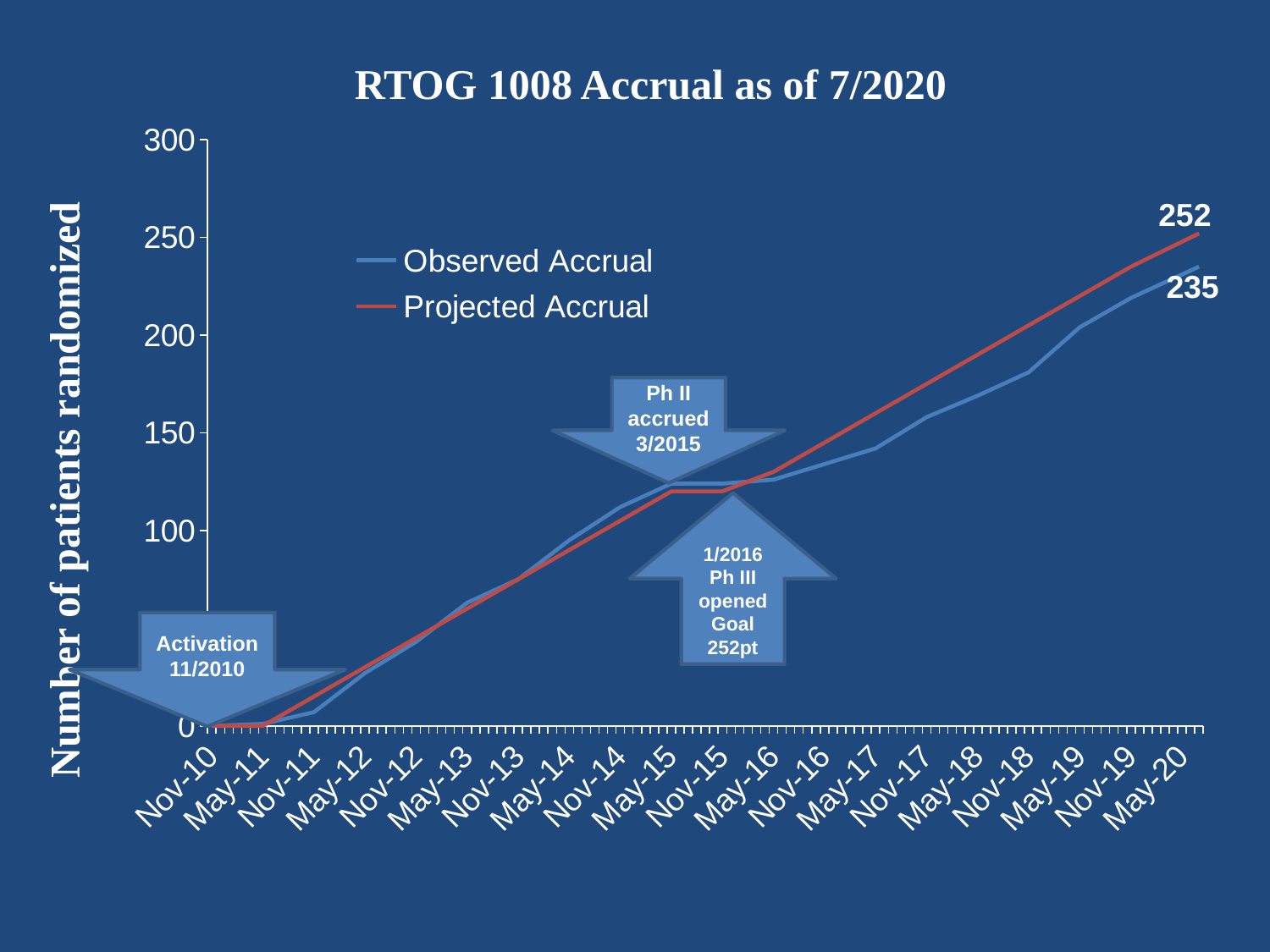
What is the difference between the final Projected Accrual value and the final Observed Accrual value? 17 Do the accrual lines rise or fall from Nov-10 to May-20? rise What kind of chart is shown on the slide? line chart Is the Observed Accrual value at Nov-13 greater or less than 100? less How many series does the legend list? 2 What is the label of the vertical axis? Number of patients randomized At the end of the chart, which line is higher: Observed Accrual or Projected Accrual? Projected Accrual Is the Projected Accrual value at May-19 greater or less than 200? greater What is the title of the chart? RTOG 1008 Accrual as of 7/2020 What is the final labelled value of the Observed Accrual line? 235 Is the Observed Accrual value at Nov-18 greater or less than 150? greater What is the final labelled value of the Projected Accrual line? 252